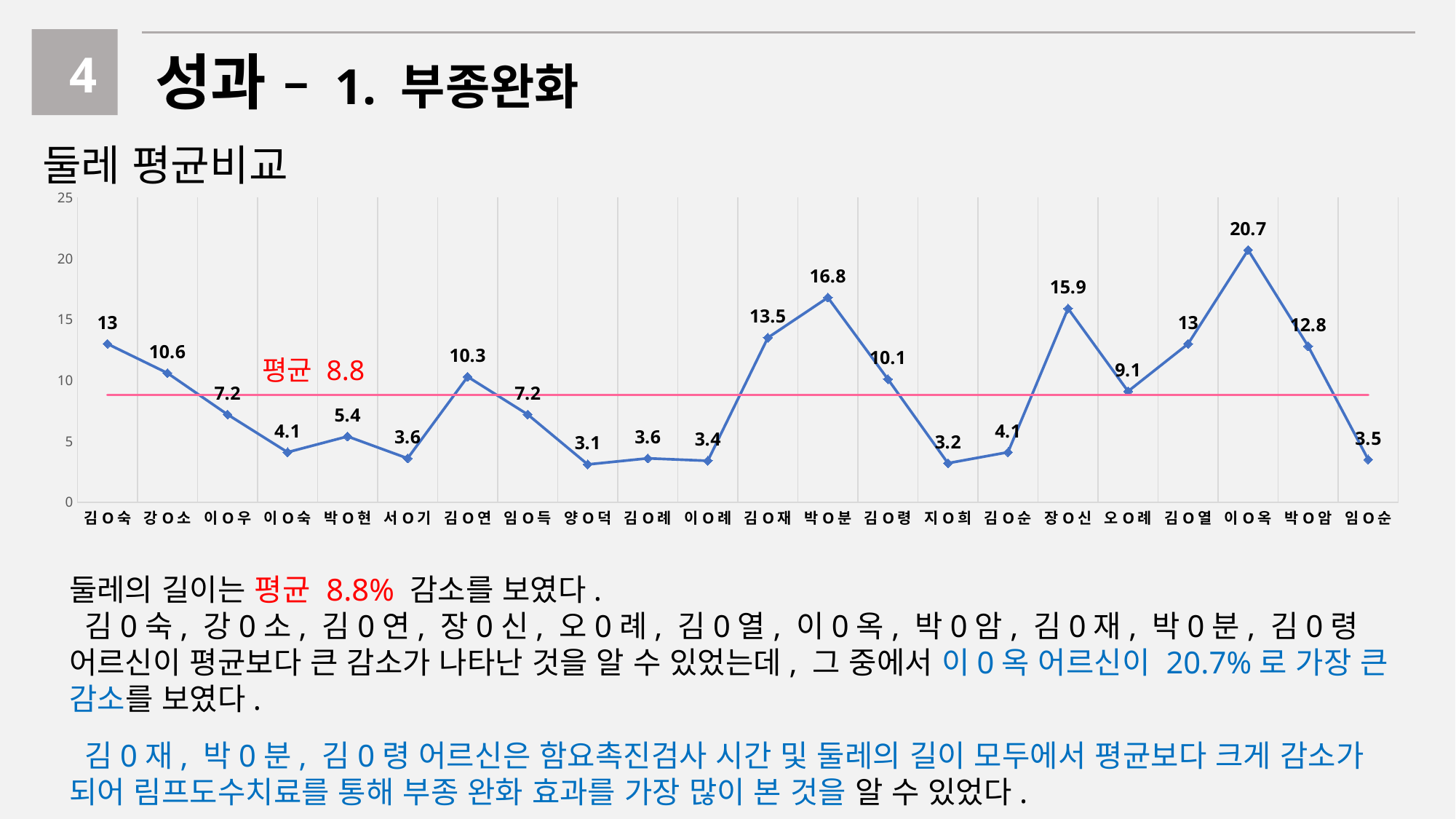
What is the value for 오O례? 9.1 What is the difference between the values for 김O재 and 김O령? 3.4 Which is larger, the value for 장O신 or the value for 김O열? 장O신 How many people (categories) are plotted on the x axis? 22 What is the value for 이O옥? 20.7 What is the value for 박O분? 16.8 What is the difference between the values for 이O옥 and 박O분? 3.9 Which person has the highest value in the chart? 이O옥 What average value is marked by the horizontal red line on the chart? 8.8 Is the value for 박O암 greater or less than 10? greater What type of chart is shown on the slide? line chart Which person has the lowest value in the chart? 양O덕